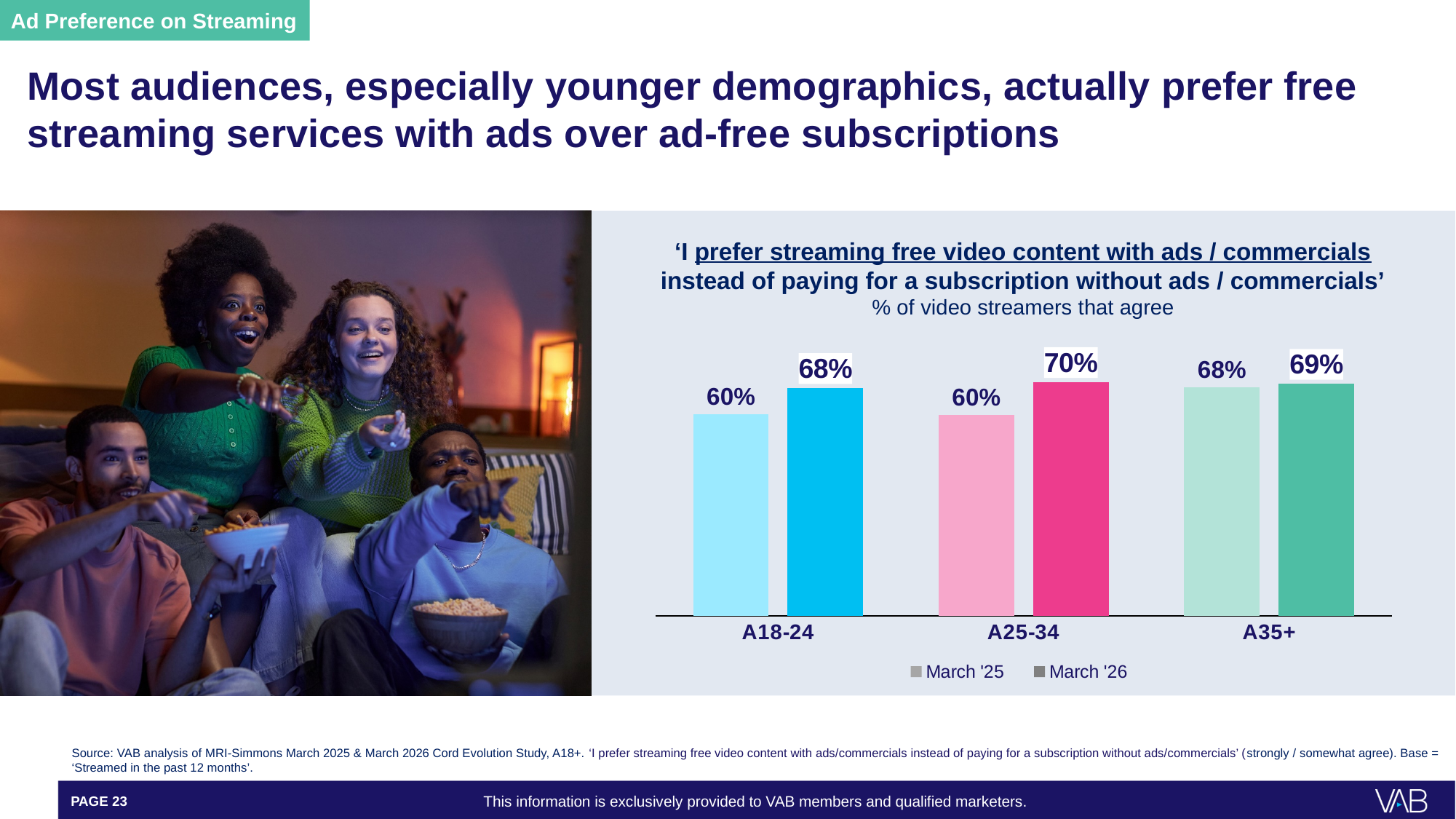
How many series does the legend list? 2 What is the difference between the March '26 and March '25 values for A35+? 1 percentage point What kind of chart is shown on the slide? Bar chart Which age group has the highest March '26 value? A25-34 Which is larger: the March '26 value for A18-24 or the March '26 value for A35+? March '26 value for A35+ What are the two series listed in the legend? March '25 and March '26 What is the March '26 value for A25-34? 70% What is the March '25 value for A18-24? 60% Which age group has the lowest March '26 value? A18-24 What is the difference between the March '26 and March '25 values for A18-24? 8 percentage points How many age groups are shown on the x axis? 3 What is the March '25 value for A35+? 68%